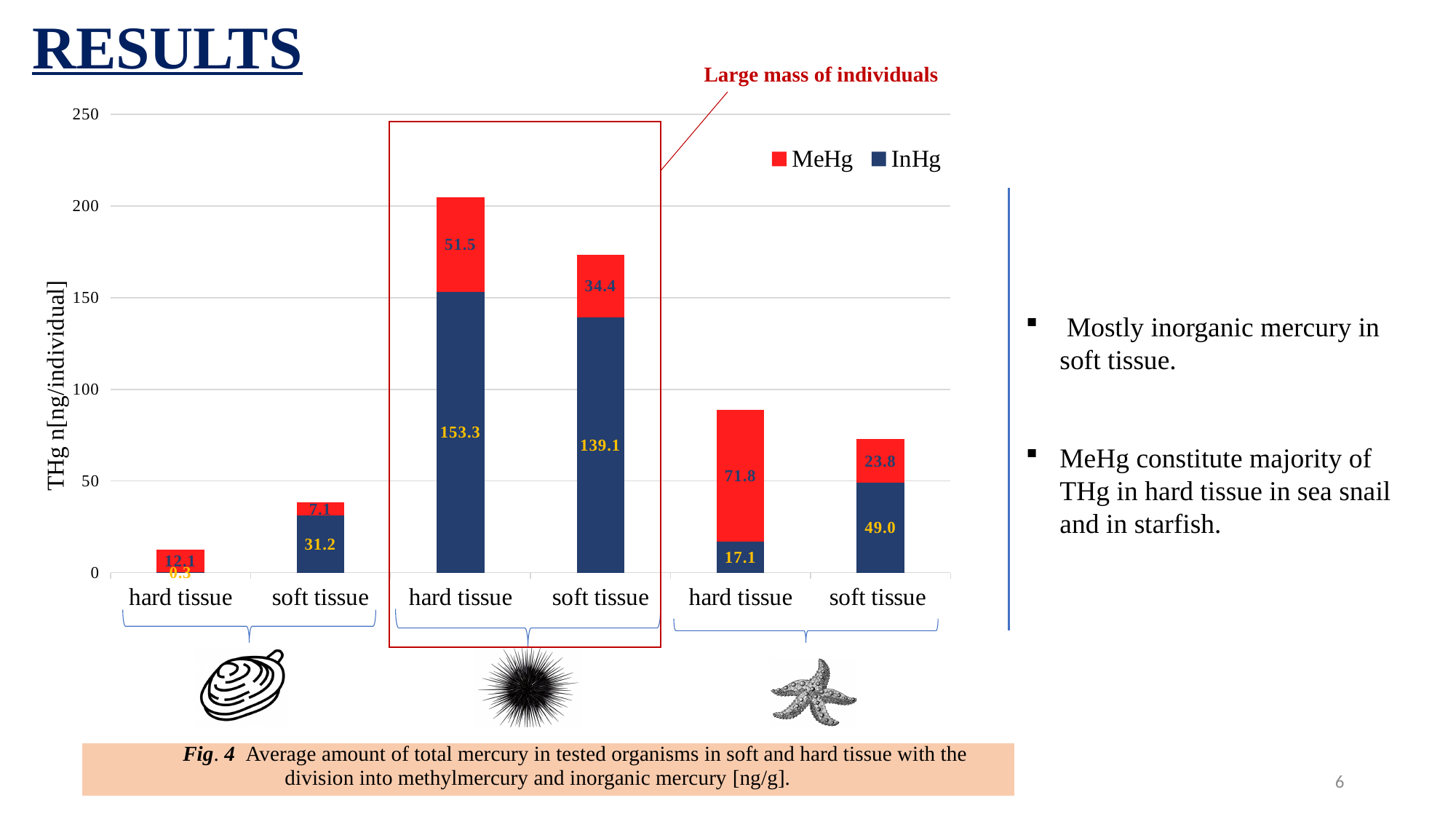
What is the InHg value for the soft tissue bar in the leftmost group (clam)? 31.2 Which bar has the highest total THg? Hard tissue in the middle group (sea urchin) What is the difference between the InHg values of hard tissue and soft tissue in the middle group (inside the red box)? 14.2 What is the MeHg value for the soft tissue bar in the rightmost group (starfish)? 23.8 Which colour represents MeHg in the chart? Red What type of chart is shown on the slide? Stacked bar chart In the hard tissue bar of the rightmost group (starfish), which is larger, MeHg or InHg? MeHg What is the MeHg value for the hard tissue bar in the middle group (inside the red box)? 51.5 How many series does the chart legend list? 2 What is the total THg of the hard tissue bar in the middle group (inside the red box)? 204.8 What is the InHg value for the hard tissue bar in the middle group (inside the red box)? 153.3 How many bars are plotted in the chart? 6